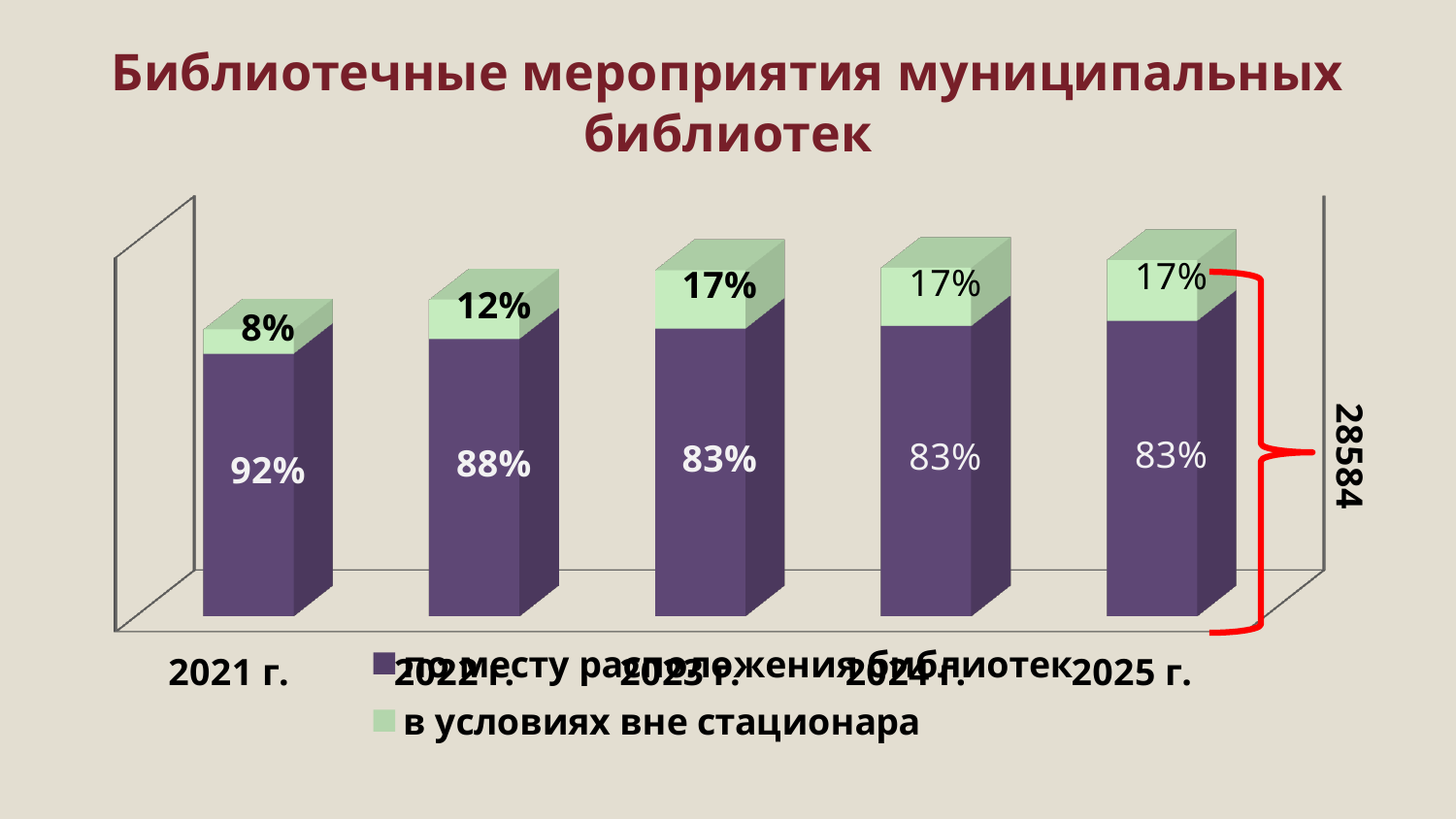
How many series does the legend list? 2 What is the value for "по месту расположения библиотек" in 2021 г.? 92% Does the share for "в условиях вне стационара" rise or fall from 2021 г. to 2023 г.? Rise Which is larger in 2022 г.: "по месту расположения библиотек" or "в условиях вне стационара"? по месту расположения библиотек How many years are shown on the x axis? 5 In which year is the share for "по месту расположения библиотек" highest? 2021 г. What is the value for "по месту расположения библиотек" in 2023 г.? 83% In which year is the share for "в условиях вне стационара" lowest? 2021 г. What is the value for "в условиях вне стационара" in 2022 г.? 12% What kind of chart is shown on the slide? Stacked bar chart What is the value for "в условиях вне стационара" in 2025 г.? 17% What is the difference between the "по месту расположения библиотек" values for 2021 г. and 2022 г.? 4%